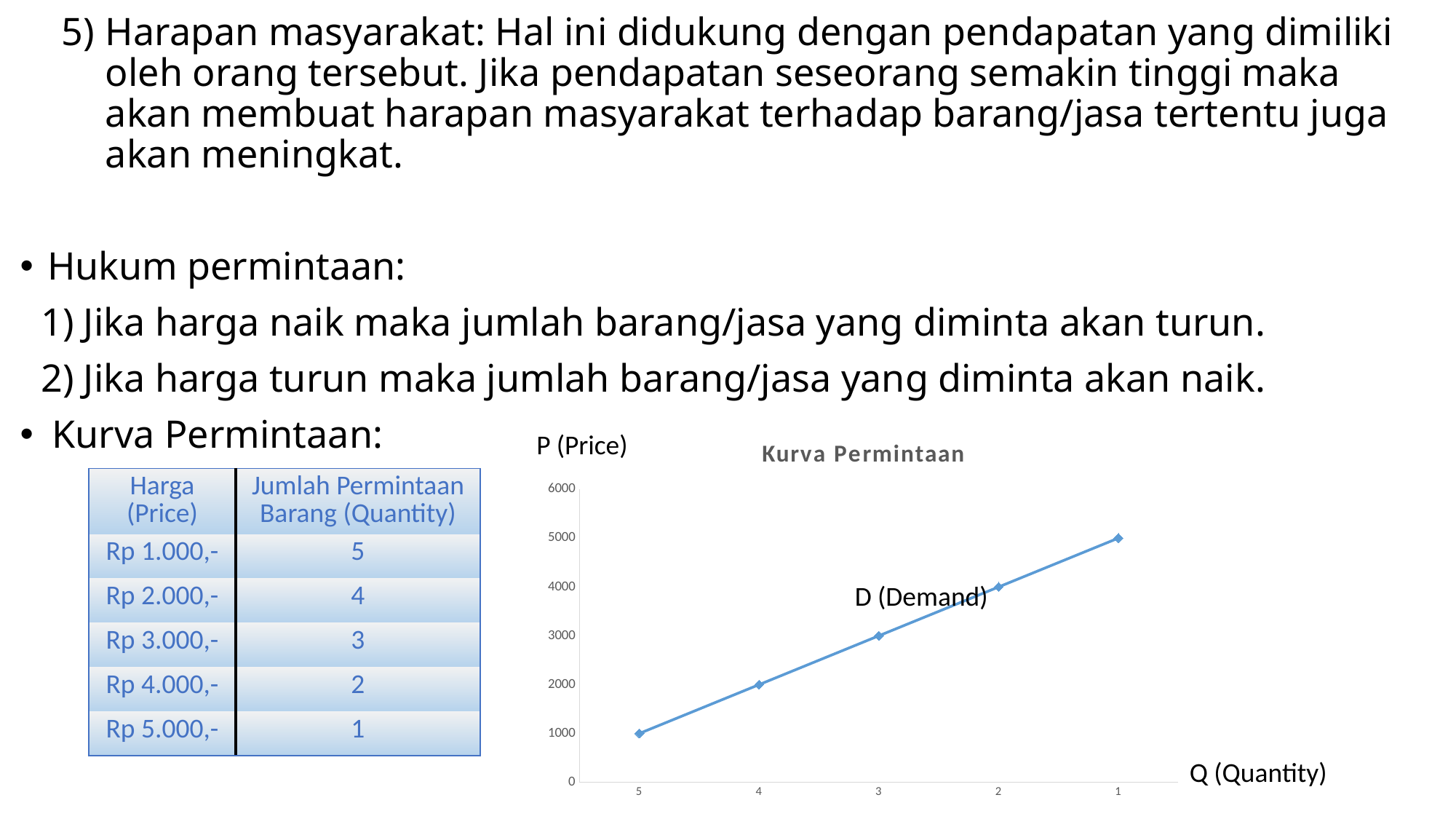
What kind of chart is shown under the title "Kurva Permintaan"? line chart What is the price value plotted at quantity 5 in the chart? 1000 Which has a higher plotted price, quantity 3 or quantity 4? quantity 3 At which quantity on the x axis is the plotted price highest? 1 Do the plotted values rise or fall moving from left to right along the x axis? rise At which quantity on the x axis is the plotted price lowest? 5 What label is written next to the line in the chart? D (Demand) What is the price value plotted at quantity 3 in the chart? 3000 What is the title of the chart? Kurva Permintaan What is the difference between the price at quantity 2 and the price at quantity 4? 2000 How many data points are plotted on the line in the chart? 5 What is the price value plotted at quantity 1 in the chart? 5000